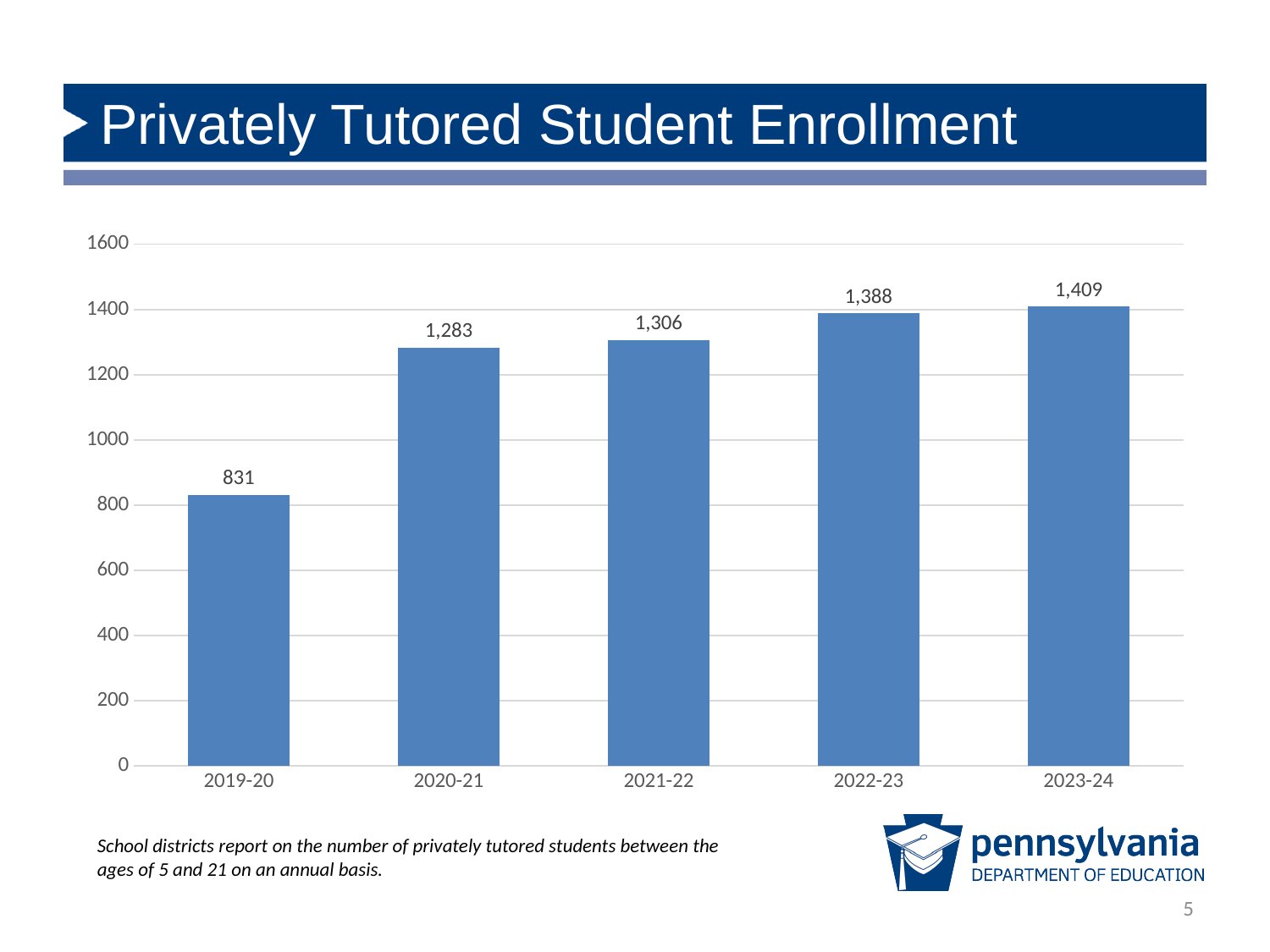
What is the privately tutored student enrollment for 2019-20? 831 What is the privately tutored student enrollment for 2023-24? 1,409 How many school years are shown on the chart? 5 Which school year has the lowest privately tutored student enrollment? 2019-20 Which year has a larger enrollment, 2020-21 or 2022-23? 2022-23 Is the enrollment for 2019-20 greater or less than 1000? less Which school year has the highest privately tutored student enrollment? 2023-24 Does privately tutored student enrollment rise or fall from 2019-20 to 2023-24? Rise What kind of chart is shown on the slide? Bar chart What is the difference in enrollment between 2020-21 and 2019-20? 452 What is the difference in enrollment between 2023-24 and 2022-23? 21 What is the privately tutored student enrollment for 2021-22? 1,306